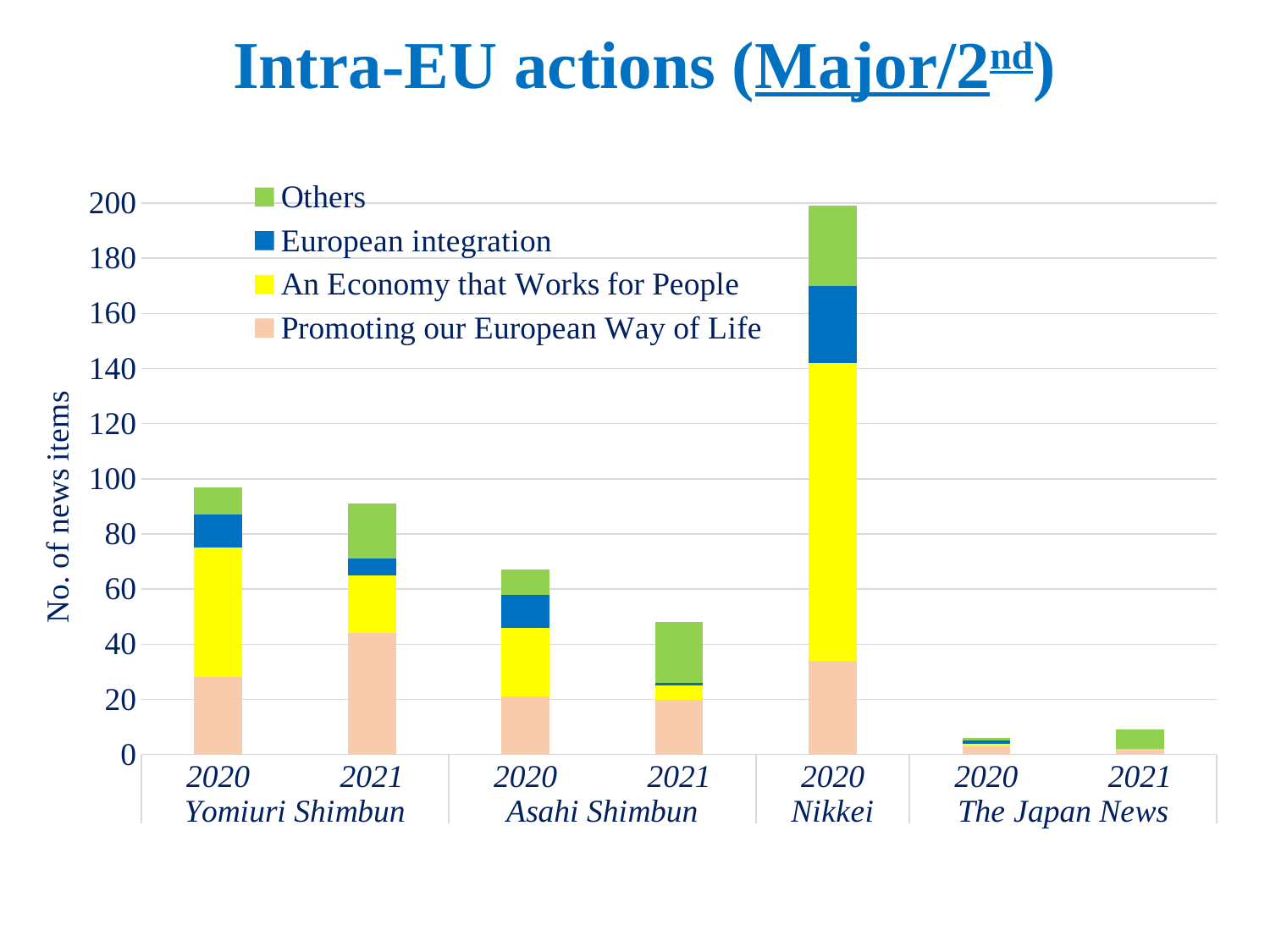
Is the total for Nikkei 2020 greater or less than 180? greater Is the total for Asahi Shimbun 2020 greater or less than 60? greater Is the total for Yomiuri Shimbun 2020 greater or less than 100? less What is the label on the vertical axis? No. of news items What is the title of the chart on the slide? Intra-EU actions (Major/2nd) What kind of chart is shown on the slide? stacked bar chart How many series does the legend list? 4 Which has a larger total, Asahi Shimbun 2020 or Asahi Shimbun 2021? Asahi Shimbun 2020 Which bar has the highest total number of news items? Nikkei 2020 How many bars are plotted in the chart? 7 Which bar has the lowest total number of news items? The Japan News 2020